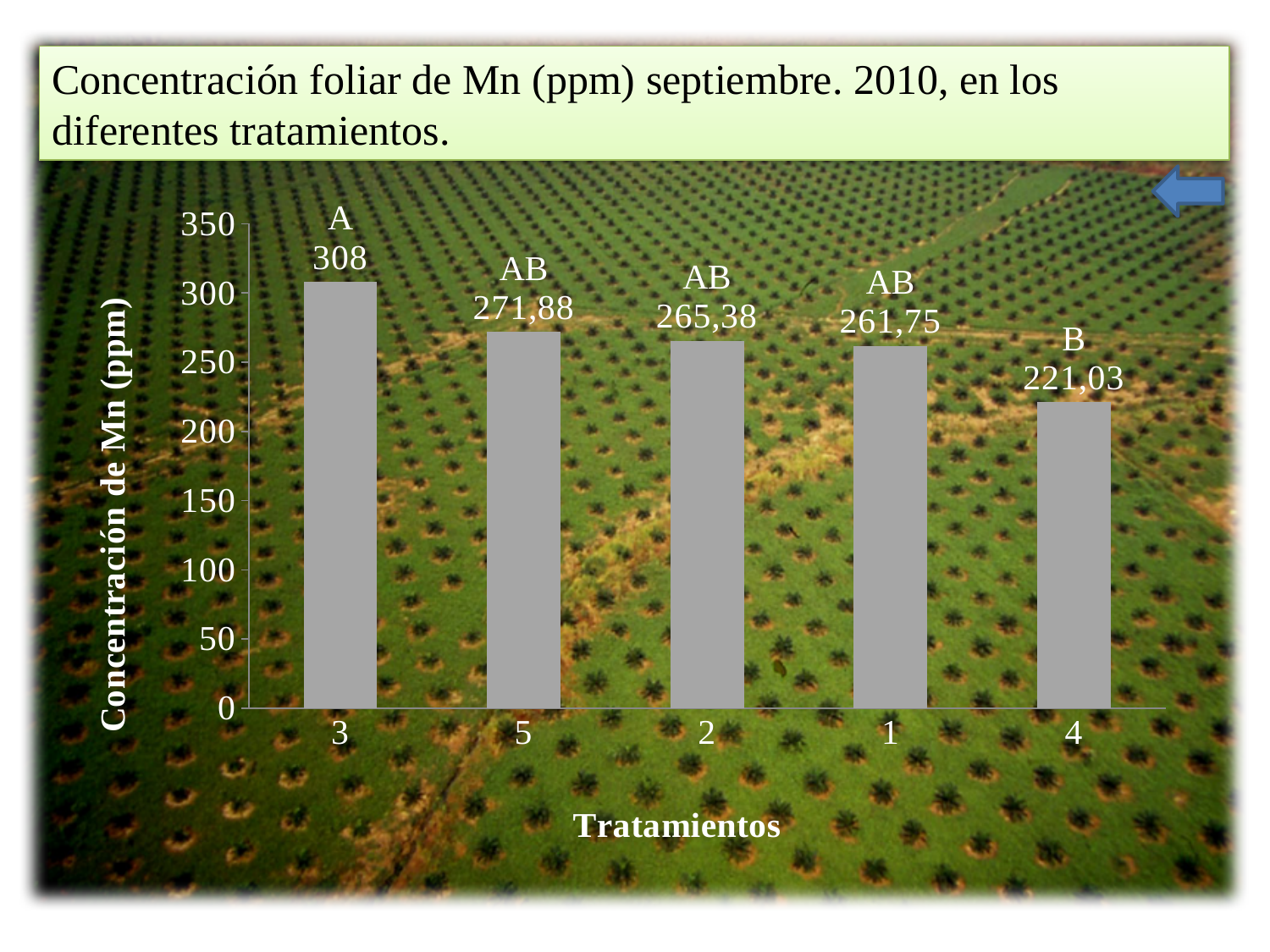
How many treatments are shown in the chart? 5 Which treatment has the highest Mn concentration? 3 What is the Mn concentration for treatment 5? 271,88 Which treatment has the lowest Mn concentration? 4 Do the values rise or fall from left to right along the x axis? Fall What is the Mn concentration for treatment 3? 308 What statistical group letter is shown above the bar for treatment 4? B What is the Mn concentration for treatment 4? 221,03 Which has a higher Mn concentration, treatment 2 or treatment 1? Treatment 2 Is the value for treatment 1 greater or less than 250? greater What is the difference in Mn concentration between treatment 3 and treatment 4? 86,97 What kind of chart is shown on the slide? Bar chart